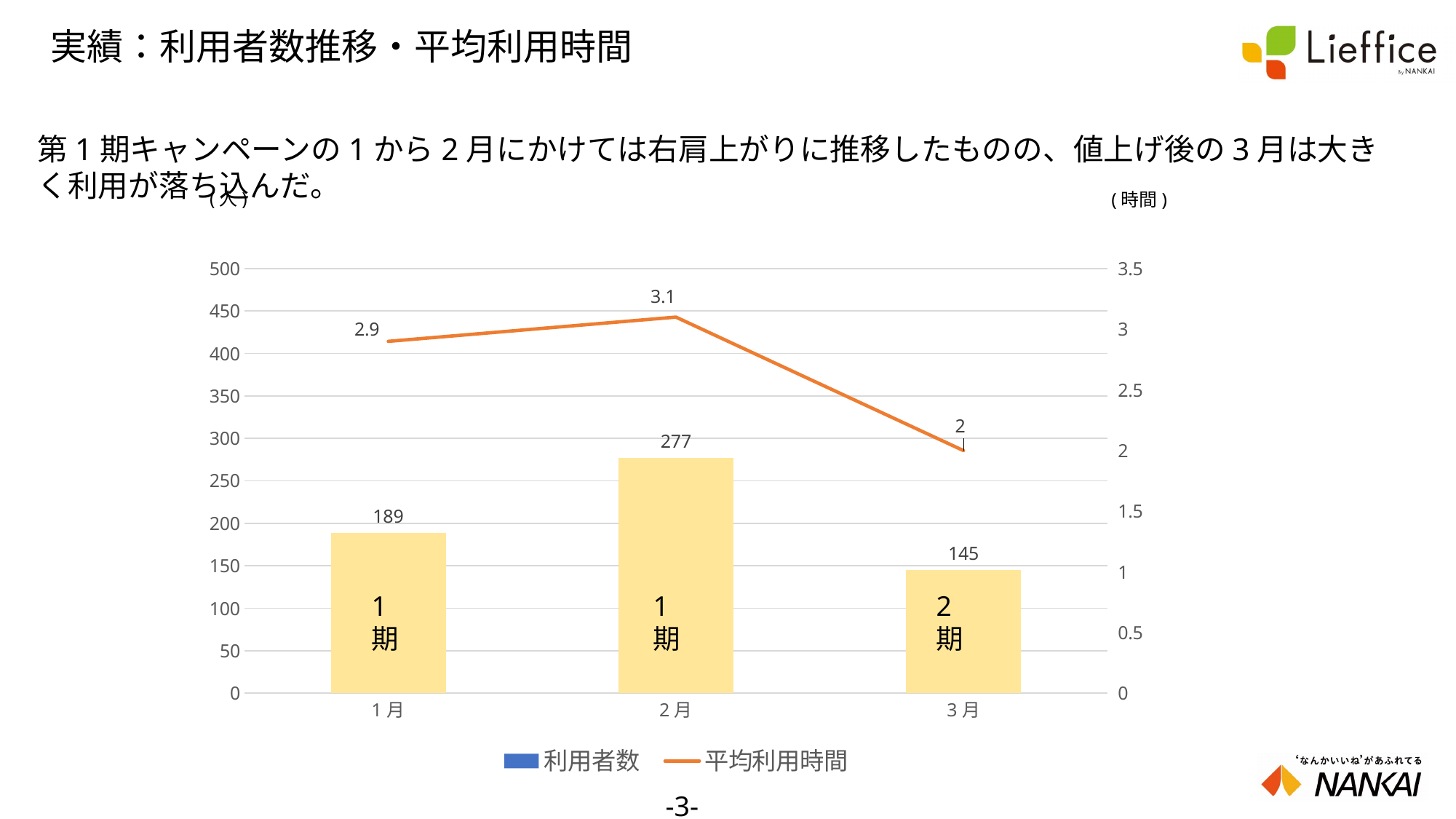
What is the difference in 利用者数 between 2月 and 3月? 132 What is the name of the series drawn as a line? 平均利用時間 What is the 利用者数 value for 2月? 277 How many series does the legend list? 2 What is the 平均利用時間 value for 1月? 2.9 How many months are shown on the x axis? 3 How does the 平均利用時間 line change from 2月 to 3月? It falls Which month has the highest 利用者数? 2月 What is the 平均利用時間 value for 3月? 2 Which is larger, the 利用者数 for 1月 or for 3月? 1月 Which month has the lowest 平均利用時間? 3月 Is the 利用者数 value for 1月 greater or less than 200? less